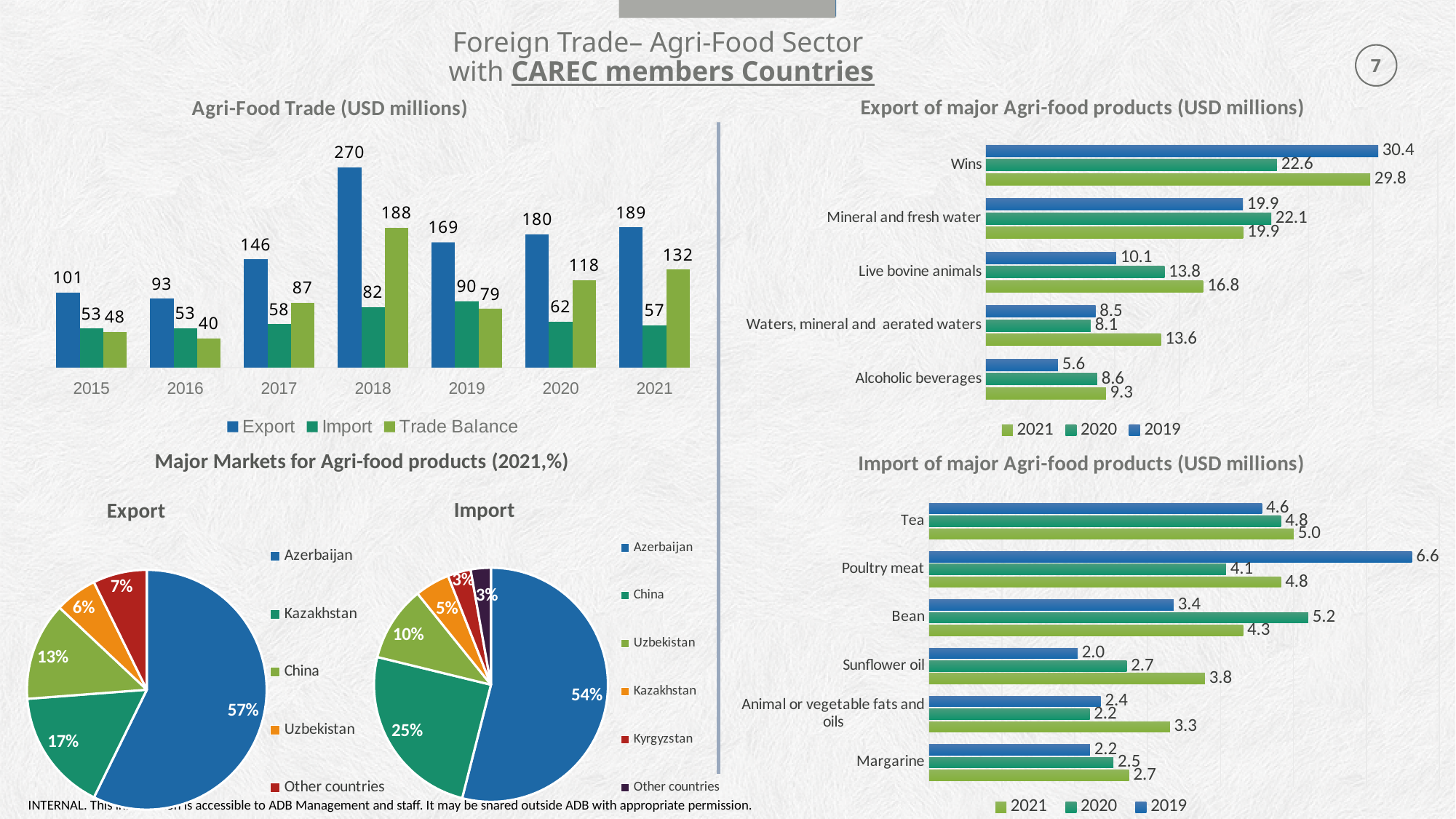
In the Export of major Agri-food products (USD millions) chart, what is the 2021 value for Live bovine animals? 16.8 In the Import pie chart under Major Markets for Agri-food products (2021,%), what share does China have? 25% In the Agri-Food Trade (USD millions) chart, what is the Export value for 2018? 270 In the Agri-Food Trade (USD millions) chart, what is the difference between Export and Import in 2021? 132 In the Agri-Food Trade (USD millions) chart, how many years are shown on the x axis? 7 In the Agri-Food Trade (USD millions) chart, which year has the highest Export value? 2018 In the Import of major Agri-food products (USD millions) chart, which is larger for Bean: the 2020 value or the 2021 value? 2020 In the Import of major Agri-food products (USD millions) chart, what is the 2019 value for Poultry meat? 6.6 In the Import pie chart under Major Markets for Agri-food products (2021,%), which country has the largest share? Azerbaijan In the Agri-Food Trade (USD millions) chart, how many series does the legend list? 3 In the Export of major Agri-food products (USD millions) chart, which product has the lowest 2019 value? Alcoholic beverages In the Export pie chart under Major Markets for Agri-food products (2021,%), what share does Kazakhstan have? 17%